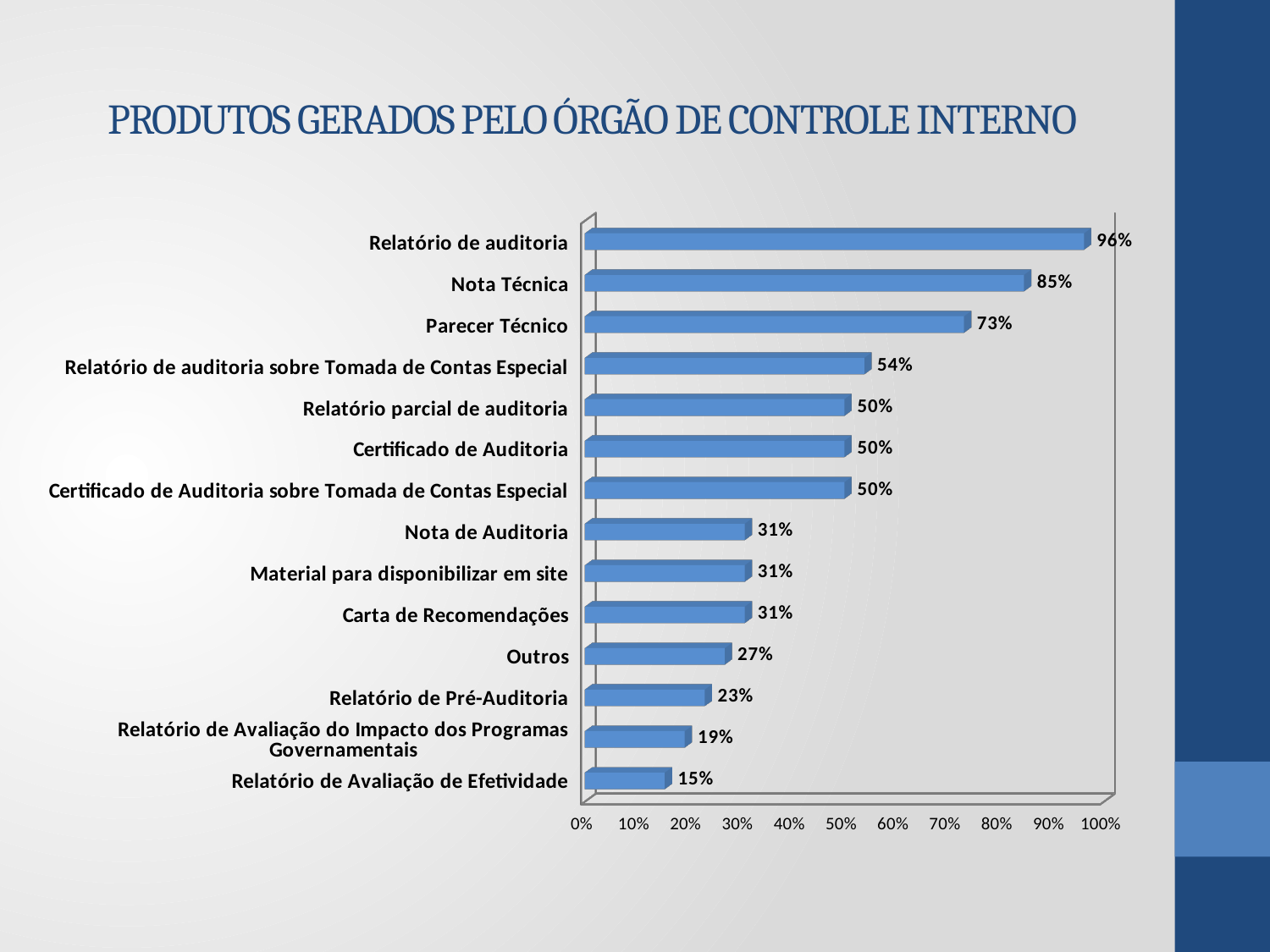
What is the value for Relatório de auditoria? 96% Which category has the highest value? Relatório de auditoria What kind of chart is shown on the slide? Bar chart Which is larger, the value for Relatório de auditoria sobre Tomada de Contas Especial or the value for Nota de Auditoria? Relatório de auditoria sobre Tomada de Contas Especial What is the value for Outros? 27% What is the title of the slide? PRODUTOS GERADOS PELO ÓRGÃO DE CONTROLE INTERNO What is the value for Relatório de Pré-Auditoria? 23% How many categories are shown in the chart? 14 What is the value for Parecer Técnico? 73% What is the difference between the values for Nota Técnica and Parecer Técnico? 12% Which category has the lowest value? Relatório de Avaliação de Efetividade What is the difference between the values for Relatório de auditoria and Relatório de Avaliação de Efetividade? 81%